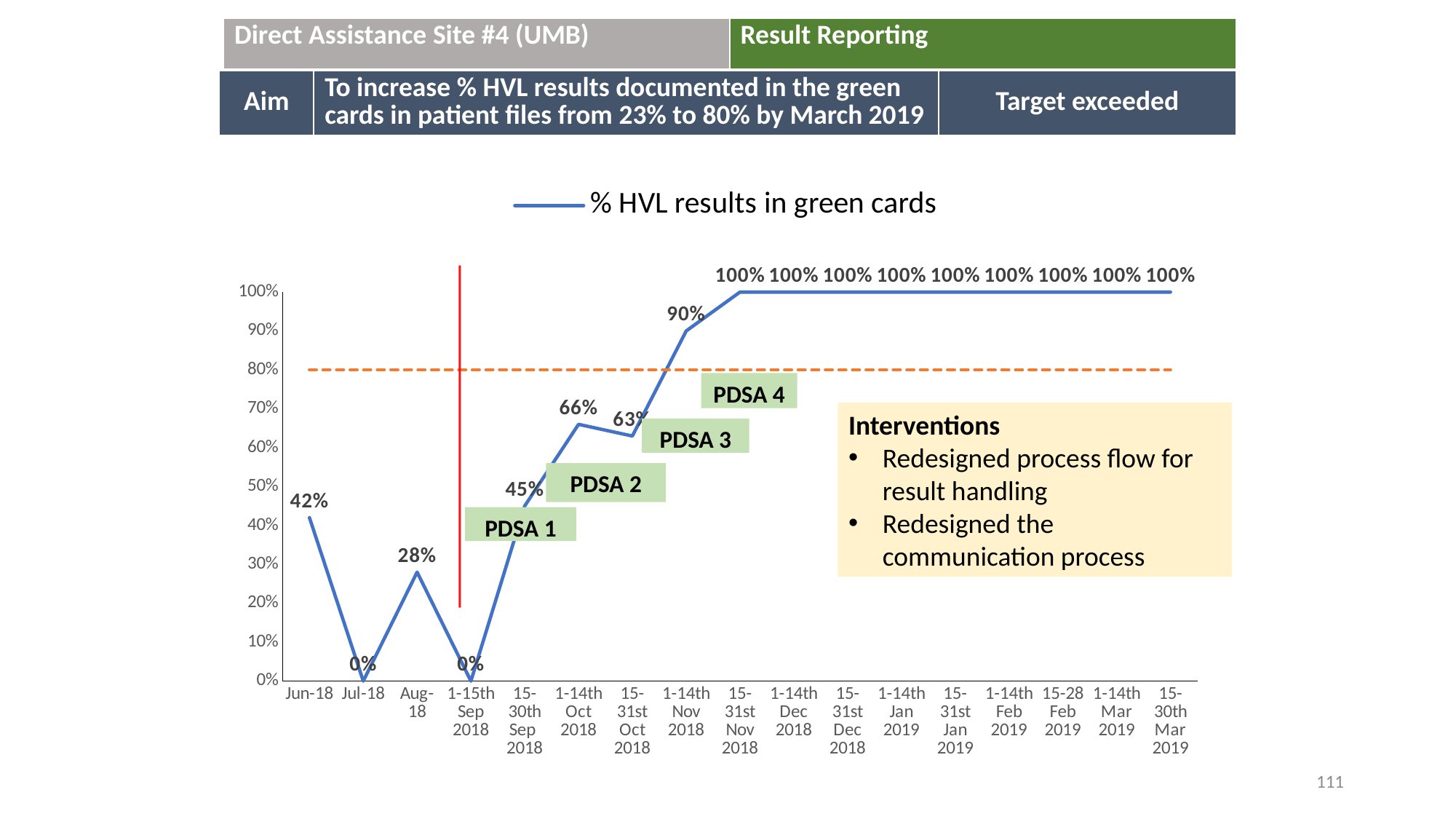
Which category has the lowest value, Jul-18 or 15-30th Sep 2018? Jul-18 What is the value for Jun-18? 42% What is the difference between the values for 1-14th Oct 2018 and 15-31st Oct 2018? 3% What is the name of the series shown in the legend? % HVL results in green cards What is the value for 15-30th Mar 2019? 100% What is the value for 1-14th Nov 2018? 90% Which is larger, the value for Jun-18 or the value for Aug-18? Jun-18 What is the value for 1-14th Oct 2018? 66% How many series does the legend list? 1 What is the value for Aug-18? 28% What kind of chart is shown? line chart How many categories are shown on the x axis? 17